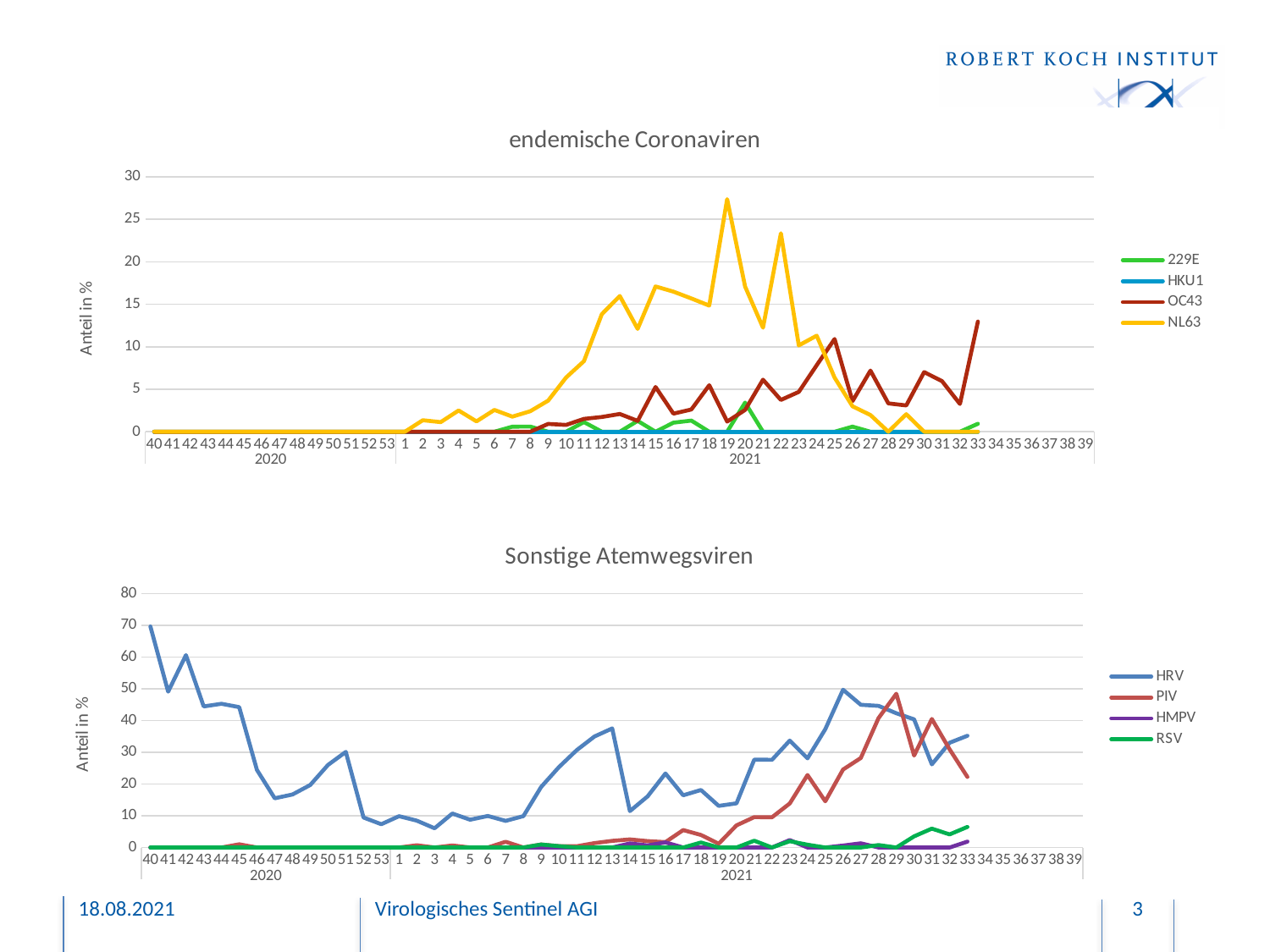
In the bottom chart "Sonstige Atemwegsviren", is the value for RSV in week 33 of 2021 greater or less than 10? less In the top chart "endemische Coronaviren", is the value for NL63 in week 19 of 2021 greater or less than 25? greater How many series does the legend of the top chart "endemische Coronaviren" list? 4 In the top chart "endemische Coronaviren", which series reaches the highest value? NL63 In the bottom chart "Sonstige Atemwegsviren", is the value for HRV in week 40 of 2020 greater or less than 60? greater What type of chart is the top chart titled "endemische Coronaviren"? line chart In the bottom chart "Sonstige Atemwegsviren", which series is larger in week 26 of 2021, HRV or PIV? HRV In the bottom chart "Sonstige Atemwegsviren", does the HRV line rise or fall from week 40 to week 47 of 2020? fall In the top chart "endemische Coronaviren", which series is larger in week 22 of 2021, NL63 or OC43? NL63 What is the y-axis label of the top chart "endemische Coronaviren"? Anteil in % How many series does the legend of the bottom chart "Sonstige Atemwegsviren" list? 4